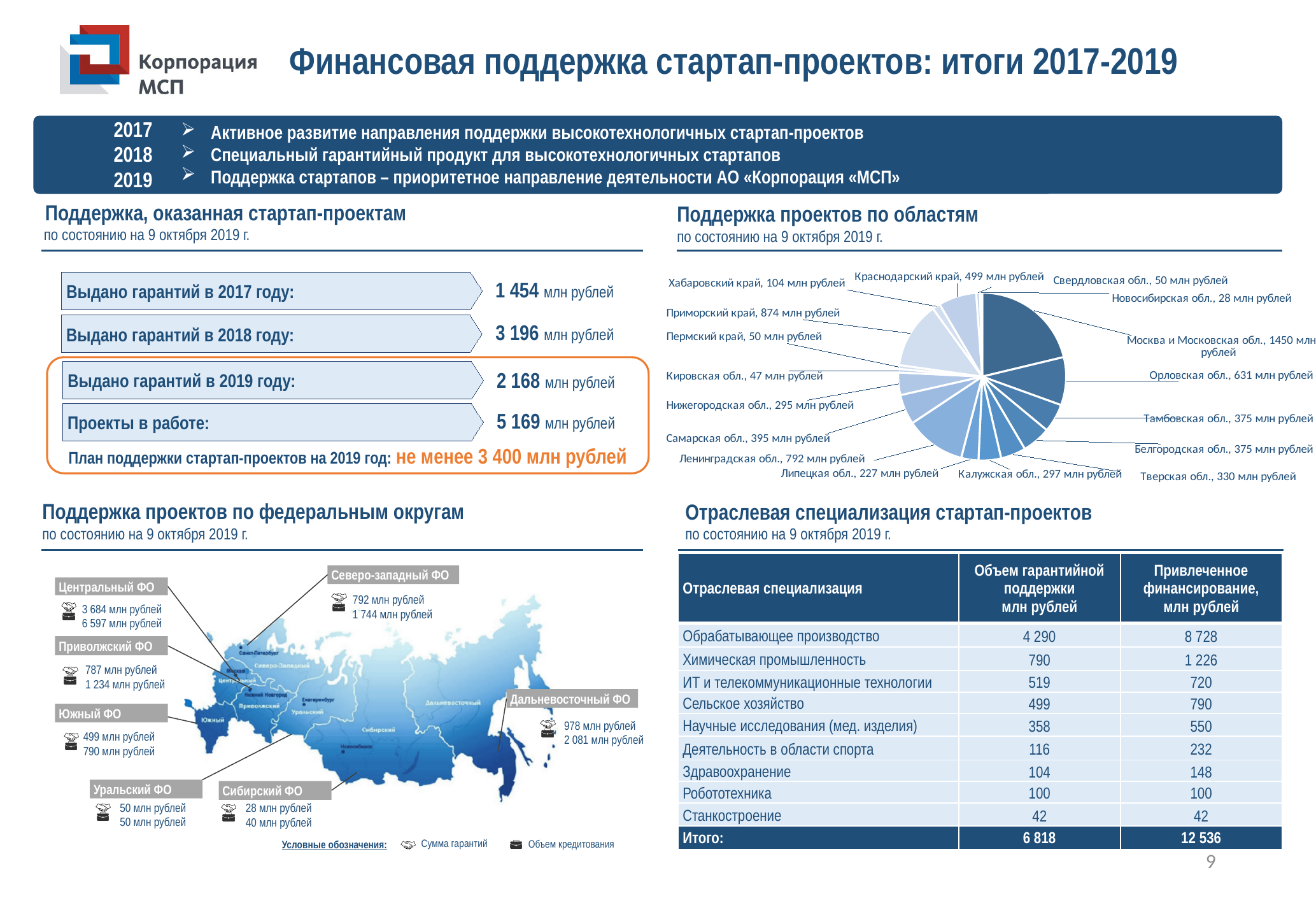
In the pie chart 'Поддержка проектов по областям', what is the value for Ленинградская обл.? 792 млн рублей In the pie chart 'Поддержка проектов по областям', what is the value for Липецкая обл.? 227 млн рублей What kind of chart is used in 'Поддержка проектов по областям'? pie chart What is the title of the pie chart on the slide? Поддержка проектов по областям In the pie chart 'Поддержка проектов по областям', which is larger: Краснодарский край or Самарская обл.? Краснодарский край How many regions (slices) are shown in the pie chart 'Поддержка проектов по областям'? 17 In the pie chart 'Поддержка проектов по областям', which region has the largest slice? Москва и Московская обл. In the pie chart 'Поддержка проектов по областям', which region has the smallest value? Новосибирская обл. In the pie chart 'Поддержка проектов по областям', what is the difference between Приморский край and Ленинградская обл.? 82 млн рублей In the pie chart 'Поддержка проектов по областям', what is the difference between Орловская обл. and Тамбовская обл.? 256 млн рублей In the pie chart 'Поддержка проектов по областям', what is the value for Москва и Московская обл.? 1450 млн рублей In the pie chart 'Поддержка проектов по областям', what is the value for Приморский край? 874 млн рублей